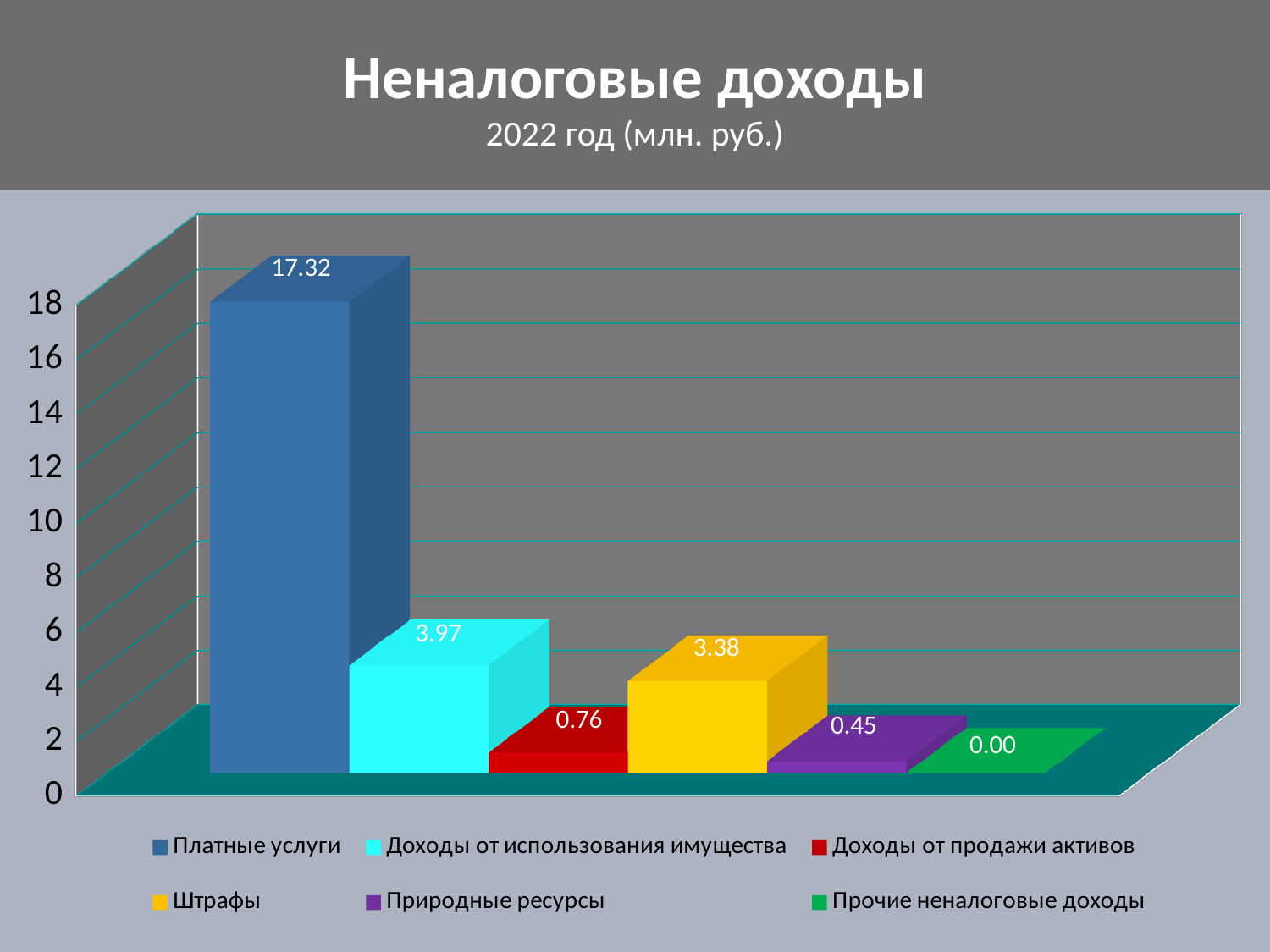
How many series does the legend list? 6 What is the title of the chart? Неналоговые доходы What is the difference between the values for Платные услуги and Доходы от использования имущества? 13.35 Which series has the highest value? Платные услуги Which is larger: Доходы от использования имущества or Штрафы? Доходы от использования имущества What is the value for Доходы от использования имущества? 3.97 What kind of chart is shown on the slide? bar chart What is the value for Штрафы? 3.38 Is the value for Платные услуги greater or less than 16? greater What is the value for Платные услуги? 17.32 What is the value for Природные ресурсы? 0.45 Which series has the lowest value? Прочие неналоговые доходы